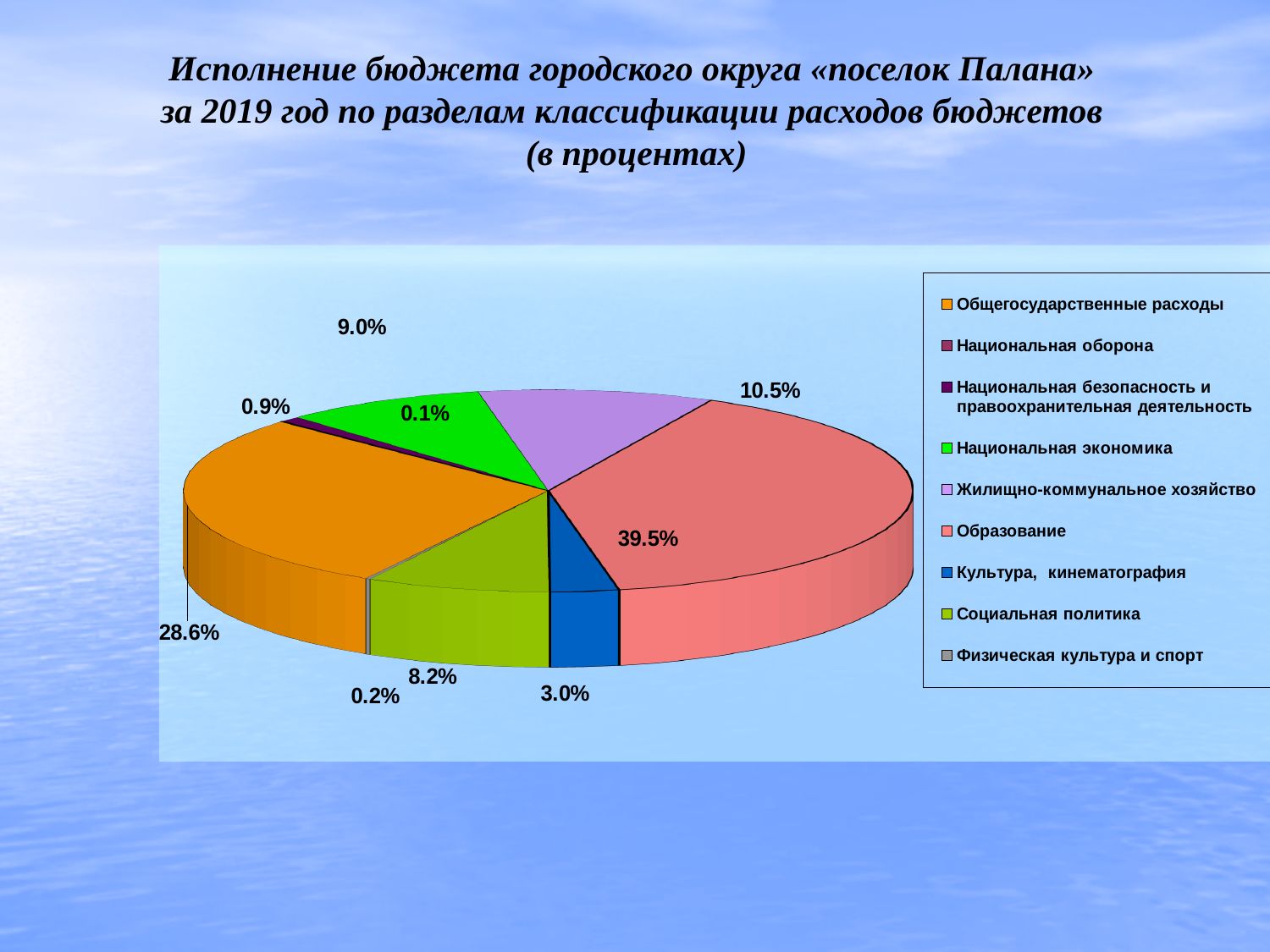
Which section has the smallest share of the budget? Национальная оборона What colour is the slice for Национальная экономика? green Which section has the largest share of the budget? Образование Which has a larger share: Национальная экономика or Жилищно-коммунальное хозяйство? Жилищно-коммунальное хозяйство What share of the budget went to Жилищно-коммунальное хозяйство? 10.5% What share of the budget went to Социальная политика? 8.2% What kind of chart is shown on the slide? pie chart What share of the budget went to Культура, кинематография? 3.0% How many sections are listed in the legend? 9 What share of the budget went to Образование? 39.5% What share of the budget went to Общегосударственные расходы? 28.6% What is the difference between the shares for Образование and Общегосударственные расходы? 10.9%